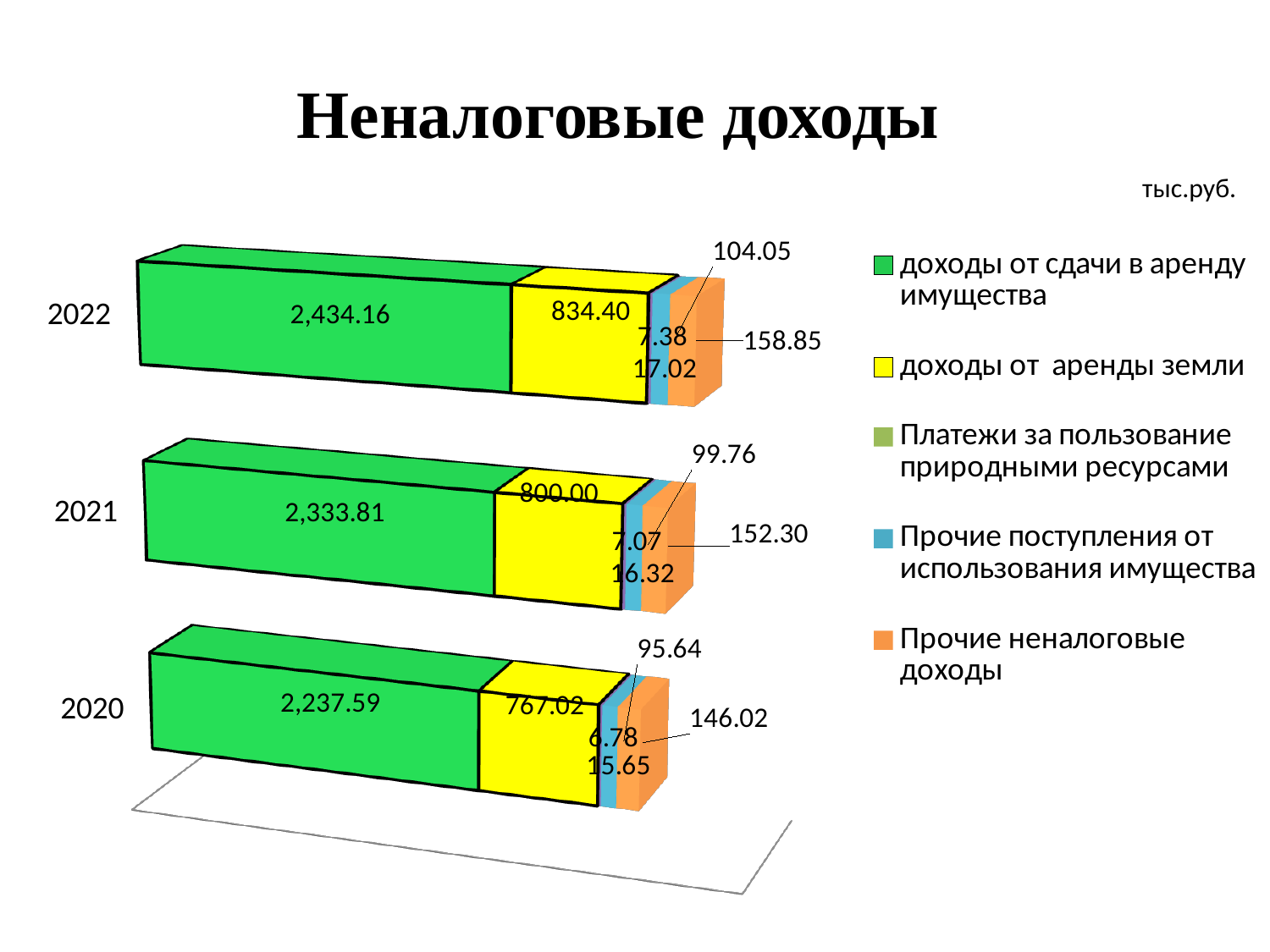
What is the difference between 'доходы от сдачи в аренду имущества' in 2022 and in 2021? 100.35 Does 'доходы от сдачи в аренду имущества' rise or fall from 2020 to 2022? rises How many series does the legend list? 5 What is the value of 'доходы от аренды земли' for 2021? 800.00 What is the value of 'доходы от сдачи в аренду имущества' for 2022? 2,434.16 What is the value of 'доходы от сдачи в аренду имущества' for 2020? 2,237.59 What kind of chart is shown on the slide? bar chart In which year is 'доходы от сдачи в аренду имущества' the highest? 2022 Which year has the larger value for 'доходы от аренды земли': 2022 or 2020? 2022 What is the title of the chart? Неналоговые доходы How many years (categories) are plotted in the chart? 3 In which year is 'доходы от аренды земли' the lowest? 2020